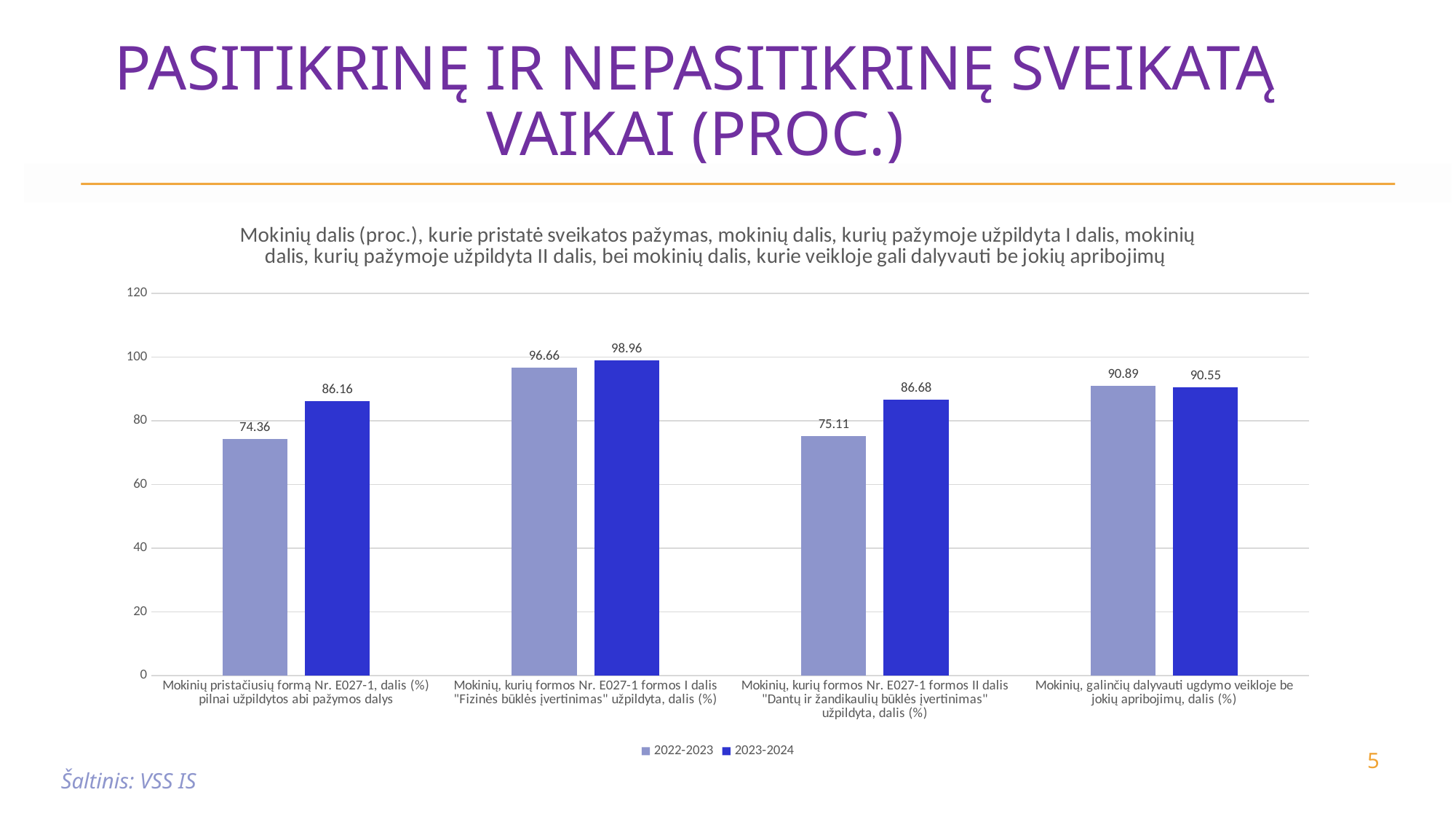
For "Mokinių, kurių formos Nr. E027-1 formos I dalis "Fizinės būklės įvertinimas" užpildyta, dalis (%)", which series has the larger value, 2022-2023 or 2023-2024? 2023-2024 How many categories are shown on the x axis of the chart? 4 What is the difference between the 2023-2024 and 2022-2023 values for "Mokinių, kurių formos Nr. E027-1 formos II dalis "Dantų ir žandikaulių būklės įvertinimas" užpildyta, dalis (%)"? 11.57 What is the 2022-2023 value for "Mokinių pristačiusių formą Nr. E027-1, dalis (%) pilnai užpildytos abi pažymos dalys"? 74.36 What is the 2023-2024 value for "Mokinių, kurių formos Nr. E027-1 formos I dalis "Fizinės būklės įvertinimas" užpildyta, dalis (%)"? 98.96 How many series does the legend list? 2 Which category has the highest 2023-2024 value? Mokinių, kurių formos Nr. E027-1 formos I dalis "Fizinės būklės įvertinimas" užpildyta, dalis (%) What is the 2023-2024 value for "Mokinių, kurių formos Nr. E027-1 formos II dalis "Dantų ir žandikaulių būklės įvertinimas" užpildyta, dalis (%)"? 86.68 What kind of chart is shown on the slide? Bar chart What is the 2022-2023 value for "Mokinių, galinčių dalyvauti ugdymo veikloje be jokių apribojimų, dalis (%)"? 90.89 What is the difference between the 2023-2024 and 2022-2023 values for "Mokinių pristačiusių formą Nr. E027-1, dalis (%) pilnai užpildytos abi pažymos dalys"? 11.80 Which category has the lowest 2022-2023 value? Mokinių pristačiusių formą Nr. E027-1, dalis (%) pilnai užpildytos abi pažymos dalys